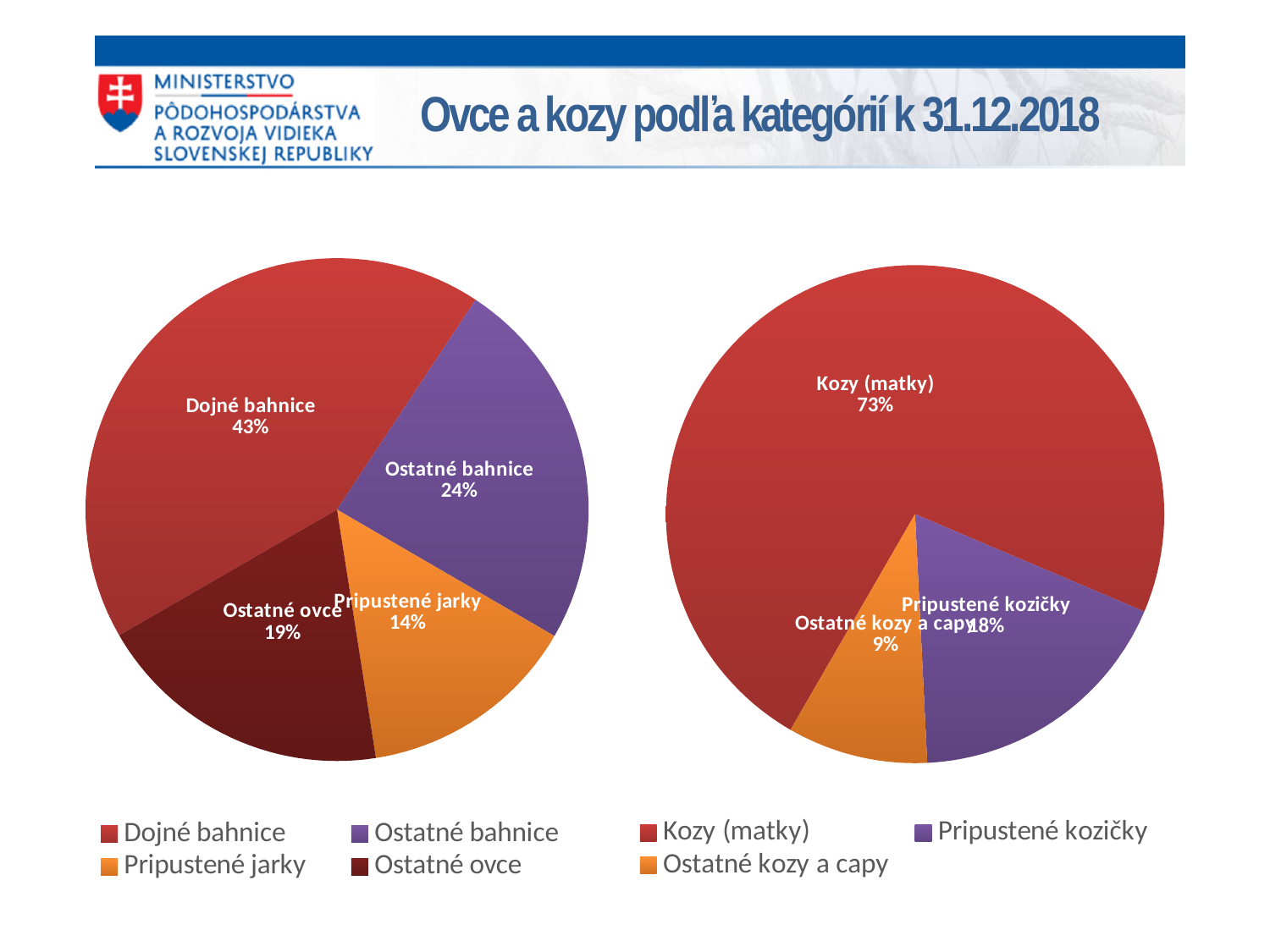
In the left pie chart, which is larger: Ostatné bahnice or Ostatné ovce? Ostatné bahnice In the left pie chart, what share is labelled for Dojné bahnice? 43% In the left pie chart, what is the difference in percentage points between Ostatné bahnice and Ostatné ovce? 5 In the right pie chart, what share is labelled for Kozy (matky)? 73% In the right pie chart, what is the difference in percentage points between Kozy (matky) and Pripustené kozičky? 55 In the right pie chart, what share is labelled for Ostatné kozy a capy? 9% In the left pie chart, which category has the smallest slice? Pripustené jarky In the left pie chart, what share is labelled for Pripustené jarky? 14% How many categories does the right pie chart show? 3 In the left pie chart, which category has the largest slice? Dojné bahnice In the right pie chart, which category has the smallest slice? Ostatné kozy a capy What type of chart is shown on the left of the slide? Pie chart